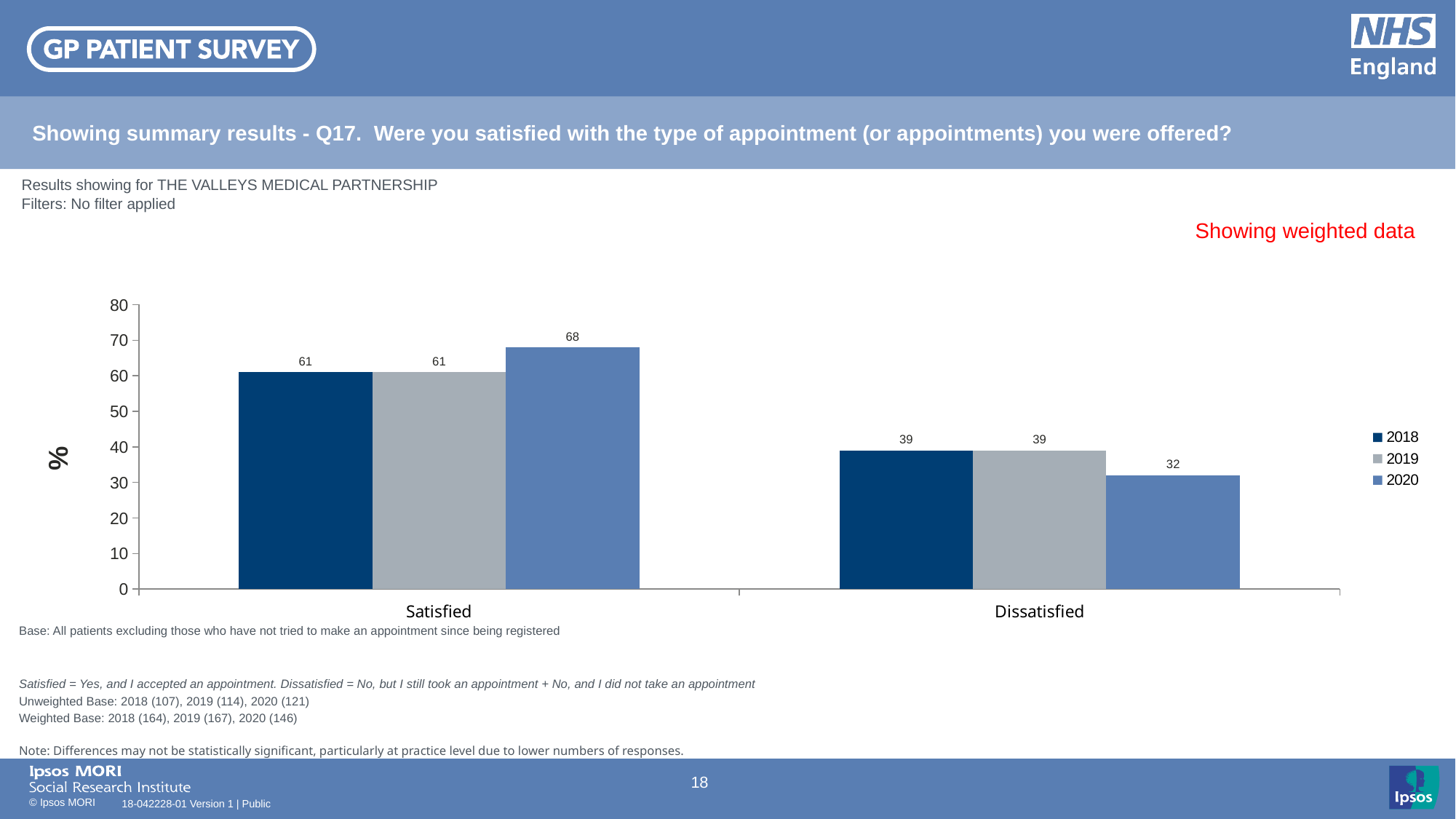
What kind of chart is shown on the slide? Bar chart How many series does the legend list? 3 What is the value for Satisfied in 2020? 68 What is the difference between the Satisfied values for 2020 and 2019? 7 What is the difference between the Dissatisfied values for 2018 and 2020? 7 Which year has the lowest value for Dissatisfied? 2020 Which is larger, the Satisfied value for 2018 or the Dissatisfied value for 2018? Satisfied What is the label on the vertical axis? % What is the value for Dissatisfied in 2020? 32 How many categories are shown on the x axis? 2 Which year has the highest value for Satisfied? 2020 What is the value for Dissatisfied in 2018? 39